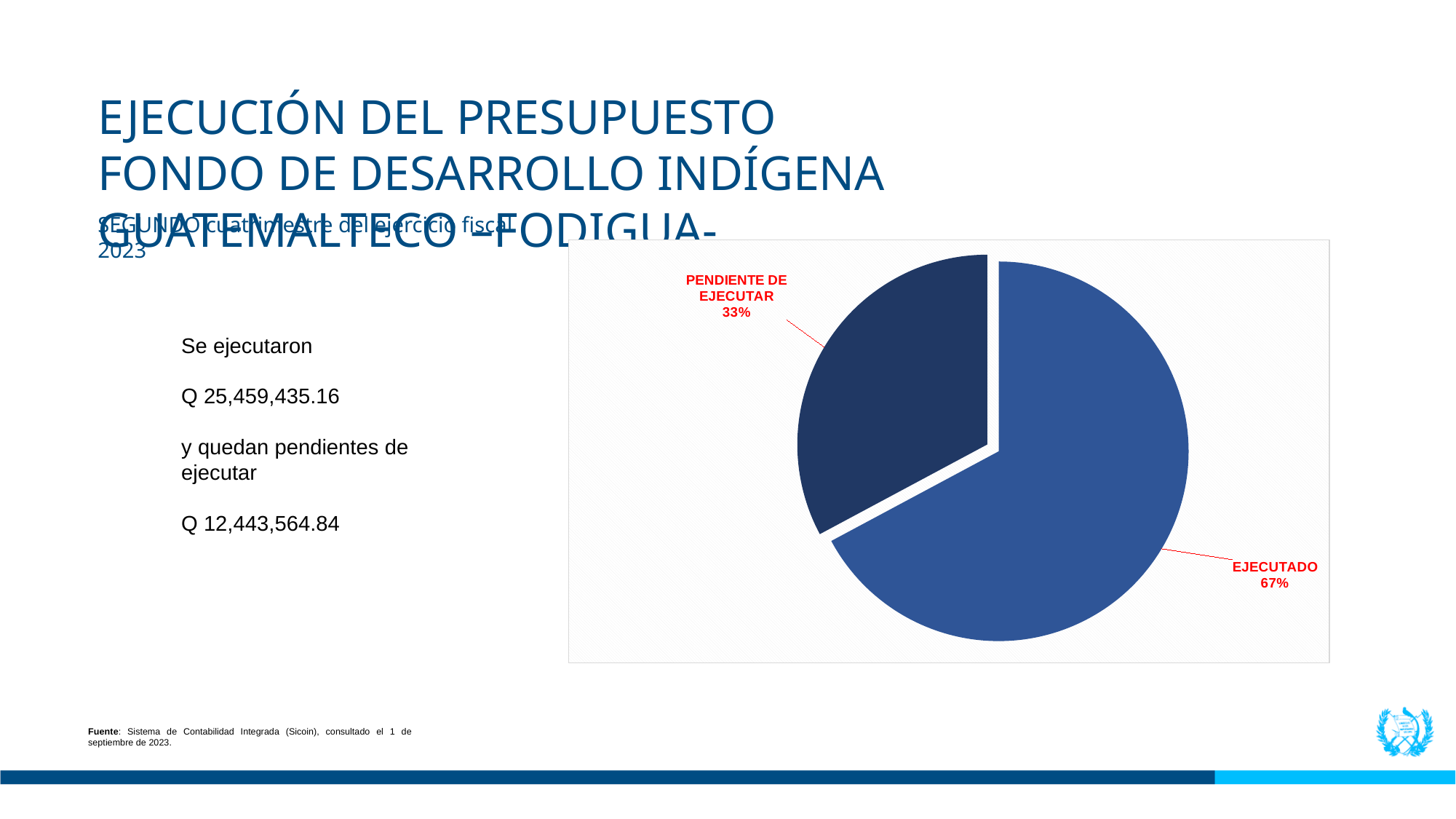
How many slices does the pie chart have? 2 What percentage does the PENDIENTE DE EJECUTAR slice show? 33% What percentage does the EJECUTADO slice show? 67% What is the difference in percentage points between the EJECUTADO and PENDIENTE DE EJECUTAR slices? 34 Which slice of the pie is the smallest? PENDIENTE DE EJECUTAR Which slice of the pie is the largest? EJECUTADO What kind of chart is shown on the slide? pie chart Which slice is pulled out (exploded) from the rest of the pie? PENDIENTE DE EJECUTAR Which is larger, the EJECUTADO slice or the PENDIENTE DE EJECUTAR slice? EJECUTADO Which slice is shown in the darker blue colour? PENDIENTE DE EJECUTAR What share of the pie does the PENDIENTE DE EJECUTAR slice represent? 33%